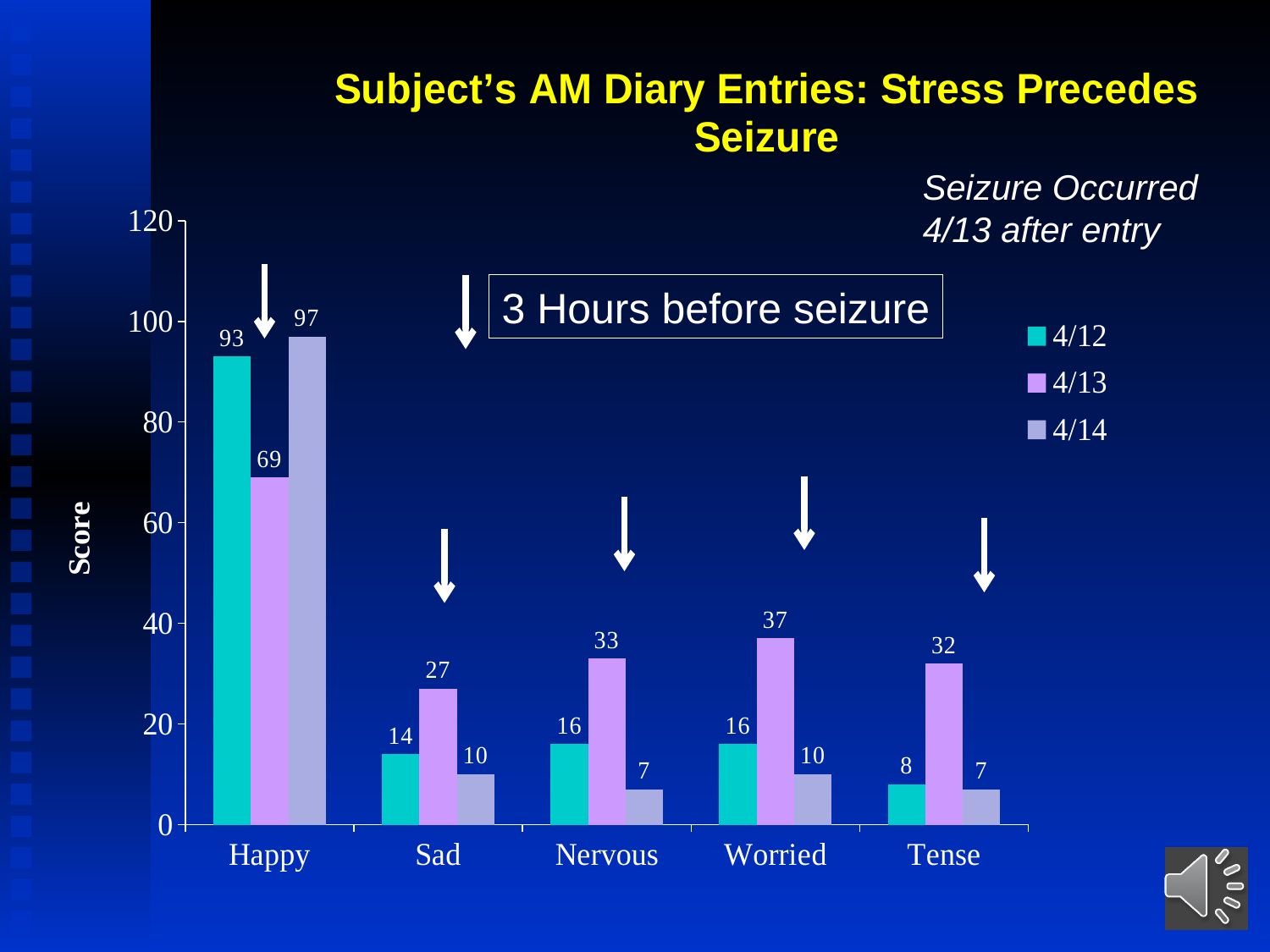
What is the difference between the 4/13 and 4/14 scores for Nervous? 26 What kind of chart is shown on the slide? bar chart Which is larger, the Sad score for 4/13 or the Sad score for 4/12? 4/13 Is the Happy score for 4/14 greater or less than 80? greater How many series does the legend list? 3 How many categories are shown on the x axis? 5 Which category has the highest 4/13 score? Happy Which category has the lowest 4/12 score? Tense What is the label on the y axis? Score What is the Happy score for 4/12? 93 What is the Worried score for 4/13? 37 What is the Tense score for 4/14? 7